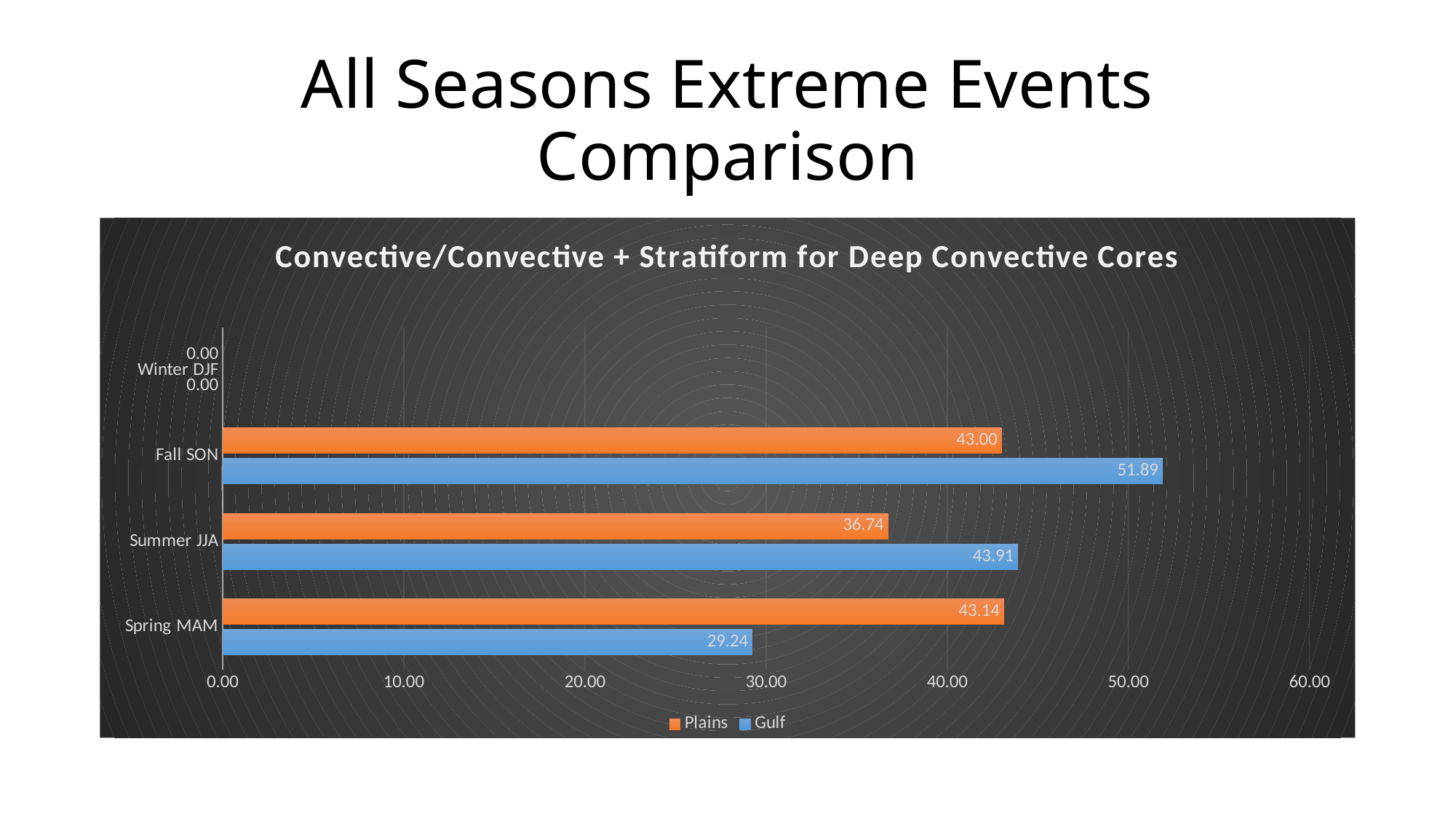
For Spring MAM, which series has the larger value, Plains or Gulf? Plains What is the Plains value for Spring MAM? 43.14 Which season has the lowest Plains value? Winter DJF What is the Gulf value for Summer JJA? 43.91 What type of chart is shown? bar chart Which season has the highest Gulf value? Fall SON What is the Gulf value for Fall SON? 51.89 What is the difference between the Gulf and Plains values for Fall SON? 8.89 What is the Plains value for Winter DJF? 0.00 How many seasons are shown on the chart? 4 How many series does the legend list? 2 Is the Gulf value for Spring MAM greater or less than 30.00? less